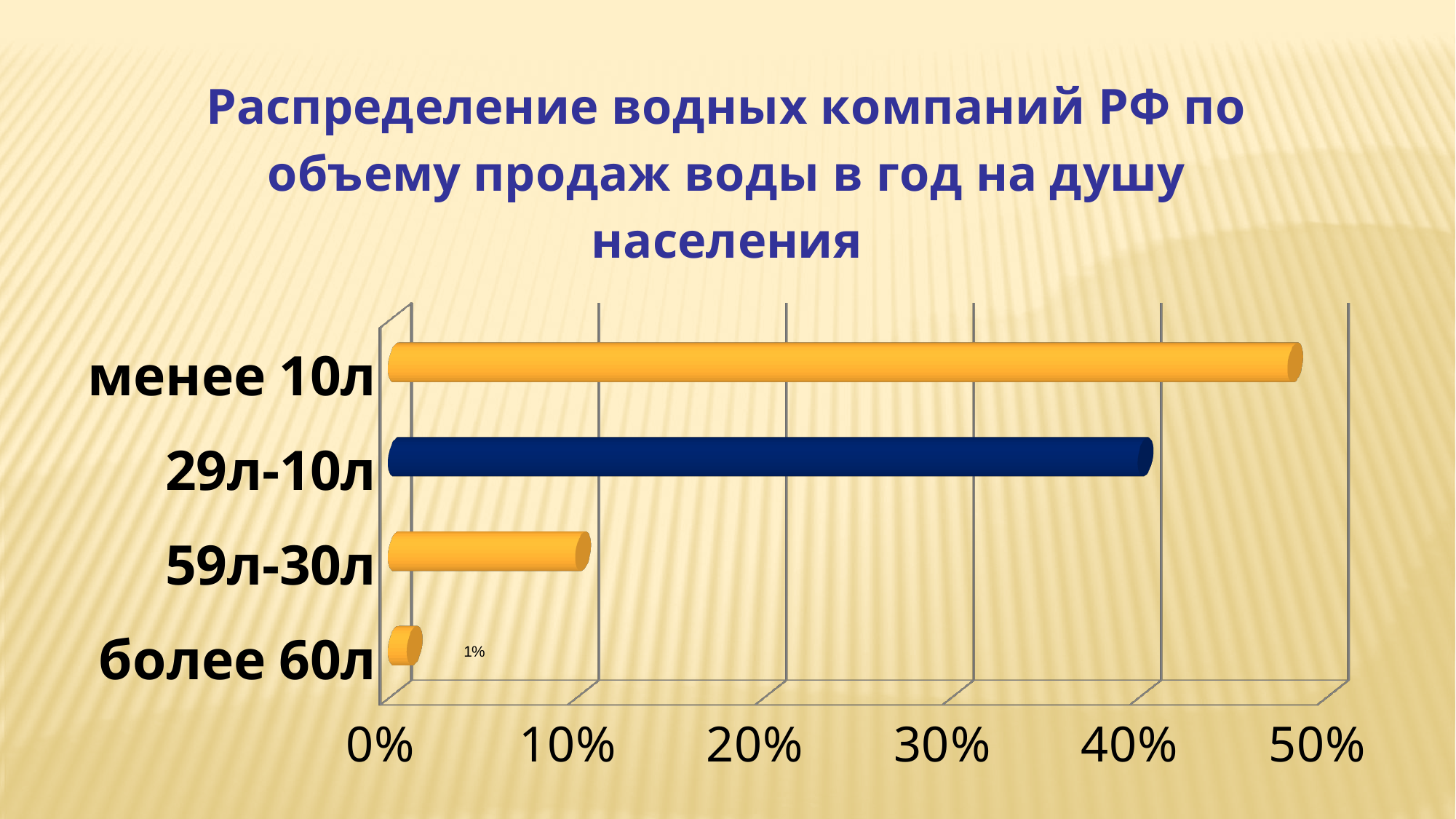
What colour is the bar for "29л-10л"? dark blue What type of chart is shown on the slide? bar chart Which is larger, the value for "59л-30л" or the value for "29л-10л"? 29л-10л Which is larger, the value for "менее 10л" or the value for "29л-10л"? менее 10л What is the value for the category "более 60л"? 1% What is the title of the chart? Распределение водных компаний РФ по объему продаж воды в год на душу населения How many categories are shown in the chart? 4 Is the value for "менее 10л" greater or less than 40%? greater Is the value for "59л-30л" greater or less than 20%? less Which category has the lowest value? более 60л Which category has the highest value? менее 10л Is the value for "29л-10л" greater or less than 30%? greater